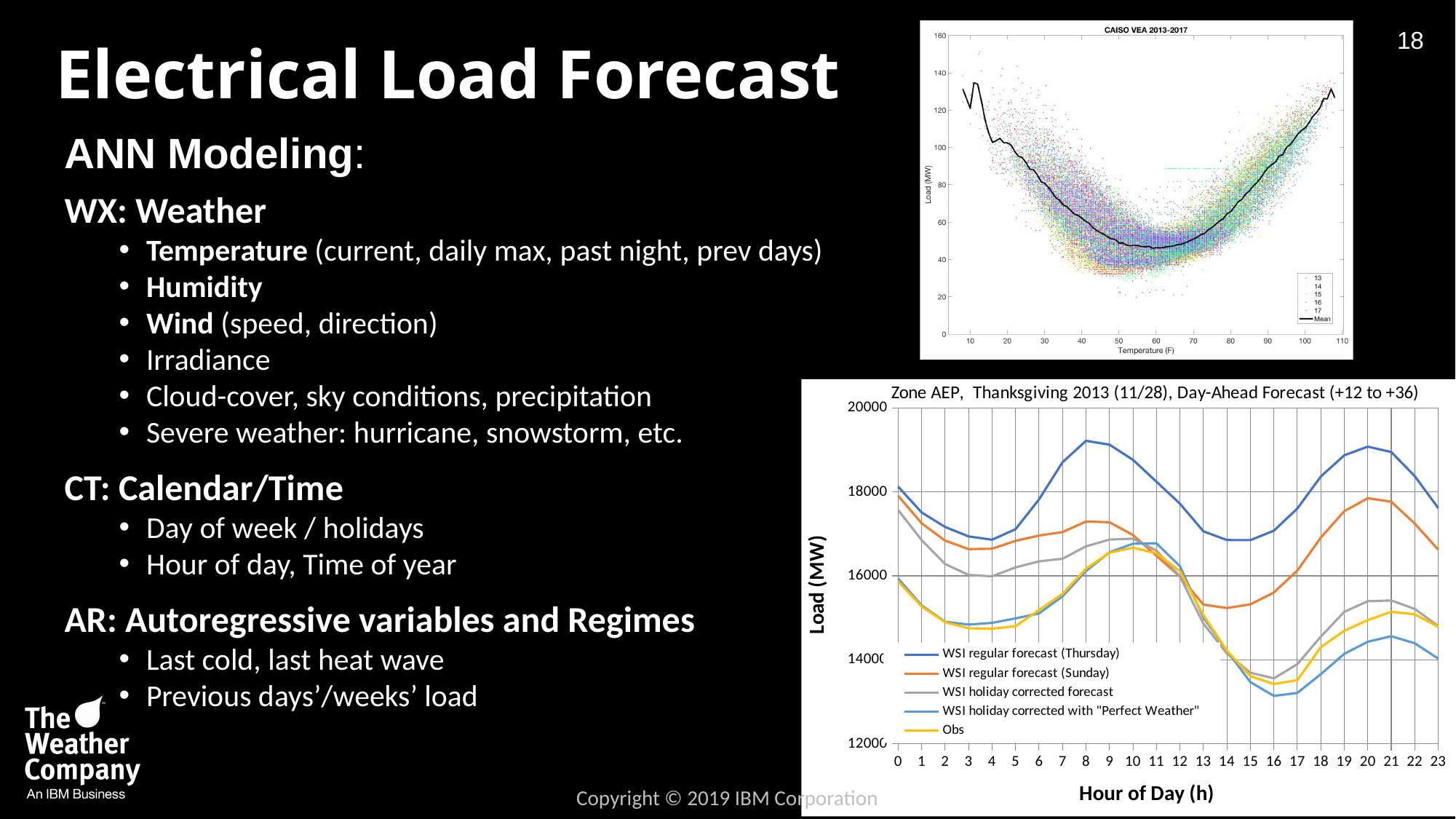
In the bottom-right Zone AEP chart, how many series does the legend list? 5 What is the title of the top-right scatter chart? CAISO VEA 2013-2017 In the bottom-right Zone AEP chart, at hour 20, which is higher: the WSI regular forecast (Thursday) or Obs? WSI regular forecast (Thursday) In the top-right CAISO VEA 2013-2017 chart, how many entries does the legend list? 6 In the bottom-right Zone AEP chart, is the value of the WSI regular forecast (Thursday) at hour 8 greater or less than 18000? greater What kind of chart is the bottom-right chart titled "Zone AEP, Thanksgiving 2013 (11/28), Day-Ahead Forecast (+12 to +36)"? Line chart In the bottom-right Zone AEP chart, does the WSI regular forecast (Thursday) rise or fall between hour 8 and hour 14? fall In the bottom-right Zone AEP chart, is the Obs value at hour 16 greater or less than 14000? less In the bottom-right Zone AEP chart, which series reaches the highest load value? WSI regular forecast (Thursday) In the bottom-right Zone AEP chart, what is the x-axis title? Hour of Day (h) In the bottom-right Zone AEP chart, is the WSI regular forecast (Sunday) value at hour 0 greater or less than 16000? greater In the bottom-right Zone AEP chart, how many hours are marked along the x axis? 24